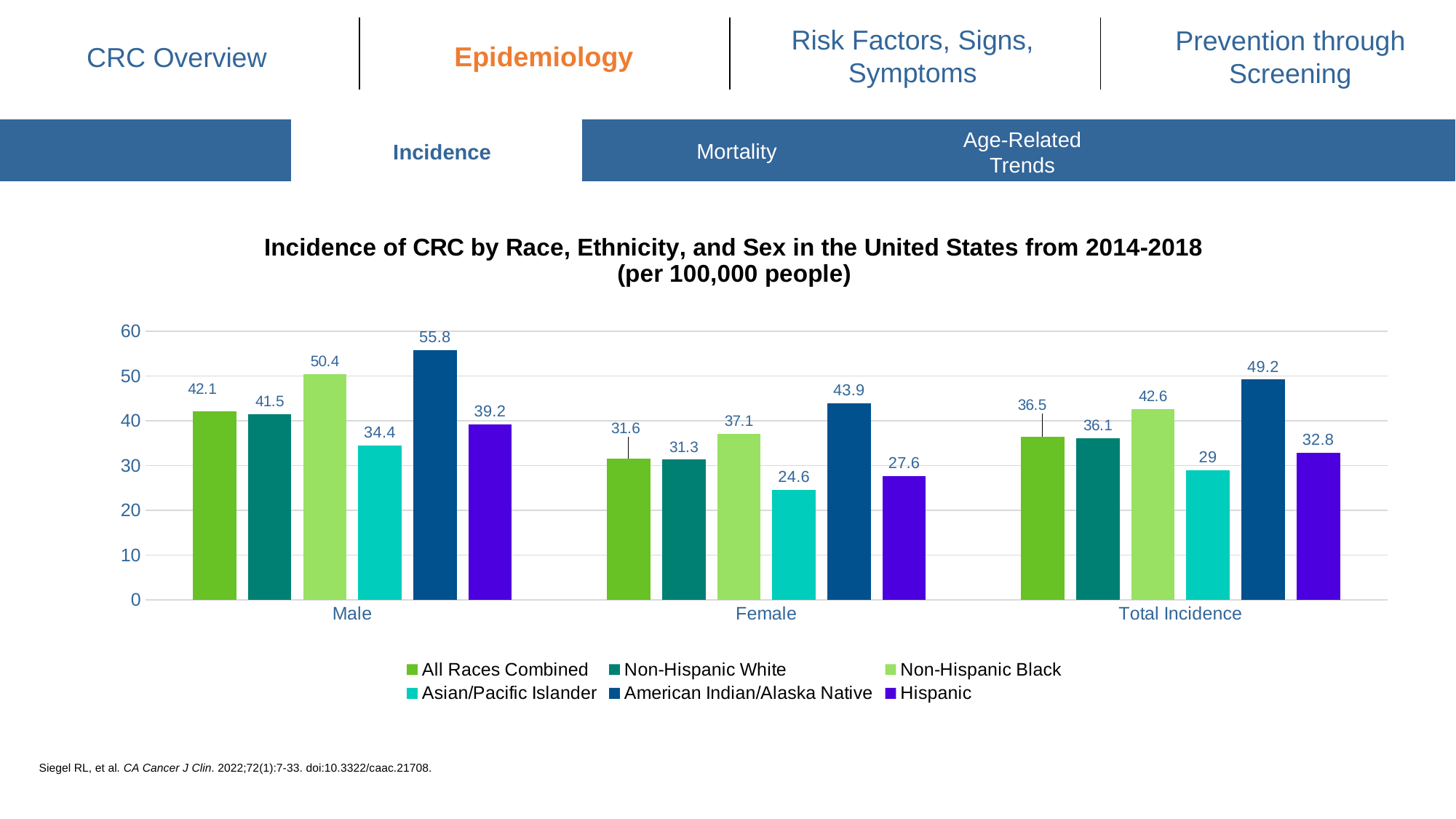
What kind of chart is shown on the slide? Bar chart Which is larger: the Total Incidence value for All Races Combined or for Non-Hispanic White? All Races Combined How many series does the legend list? 6 What is the difference between the Male and Female values for Hispanic? 11.6 What is the title of the chart? Incidence of CRC by Race, Ethnicity, and Sex in the United States from 2014-2018 (per 100,000 people) What is the Total Incidence value for Non-Hispanic Black? 42.6 How many categories are shown on the x axis? 3 Which series has the lowest value in the Female category? Asian/Pacific Islander What is the difference between the Male and Female values for Non-Hispanic Black? 13.3 What is the CRC incidence for American Indian/Alaska Native males? 55.8 What is the CRC incidence for Asian/Pacific Islander females? 24.6 Which series has the highest value in the Male category? American Indian/Alaska Native